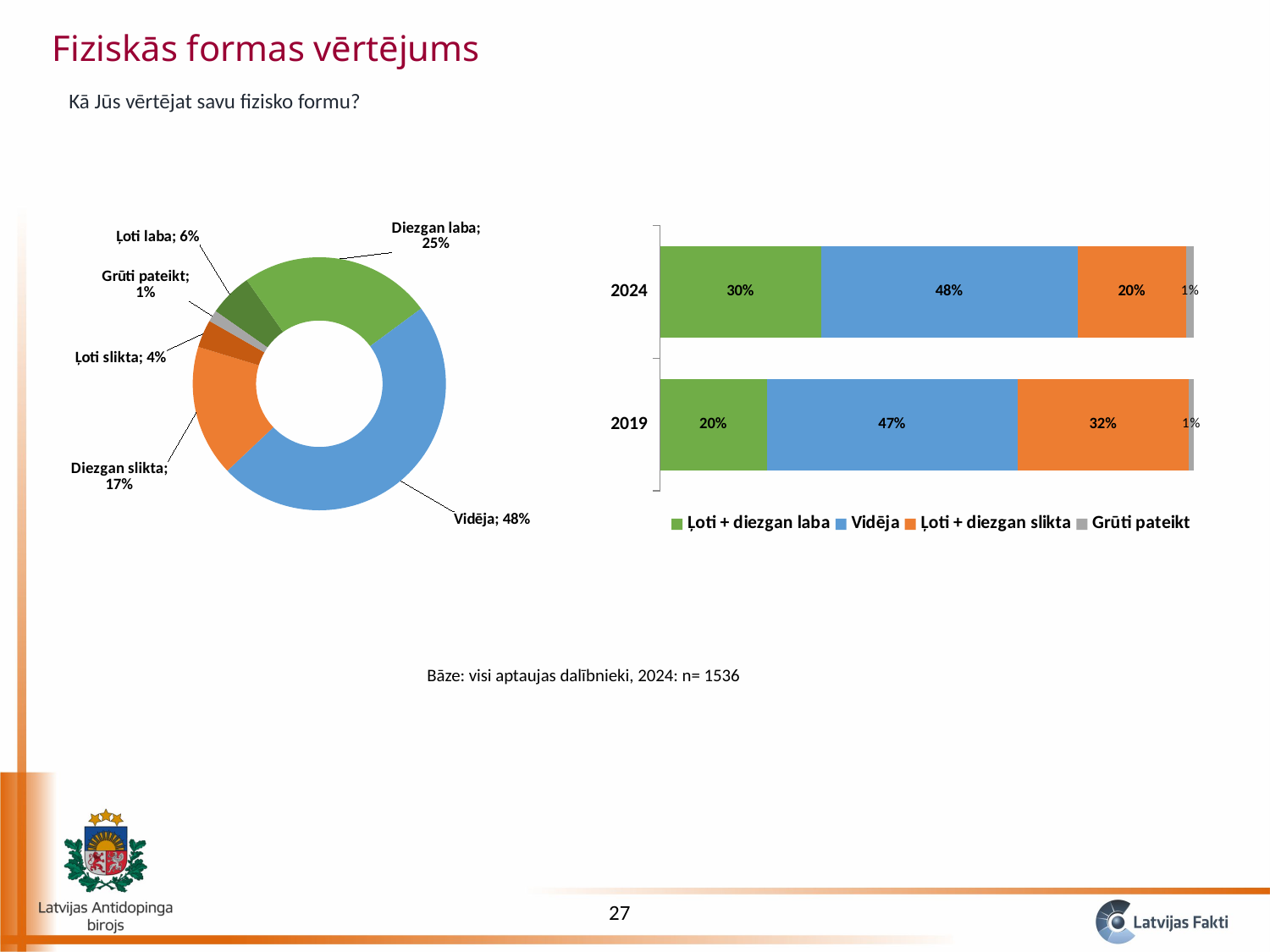
What kind of chart is shown on the right side of the slide? Stacked bar chart In the doughnut chart on the left, what share is labelled for Diezgan slikta? 17% In the stacked bar chart on the right, what is the value for Ļoti + diezgan laba in 2024? 30% In the doughnut chart on the left, what share is labelled for Vidēja? 48% In the stacked bar chart on the right, what is the value for Ļoti + diezgan slikta in 2019? 32% In the doughnut chart on the left, which category has the smallest share? Grūti pateikt In the doughnut chart on the left, what is the difference between the shares for Diezgan laba and Ļoti laba? 19% In the stacked bar chart on the right, is the value for Ļoti + diezgan slikta larger in 2019 or in 2024? 2019 In the stacked bar chart on the right, how many series does the legend list? 4 In the doughnut chart on the left, how many categories are shown? 6 In the stacked bar chart on the right, what is the difference between the Ļoti + diezgan laba values for 2024 and 2019? 10% In the doughnut chart on the left, which category has the largest share? Vidēja